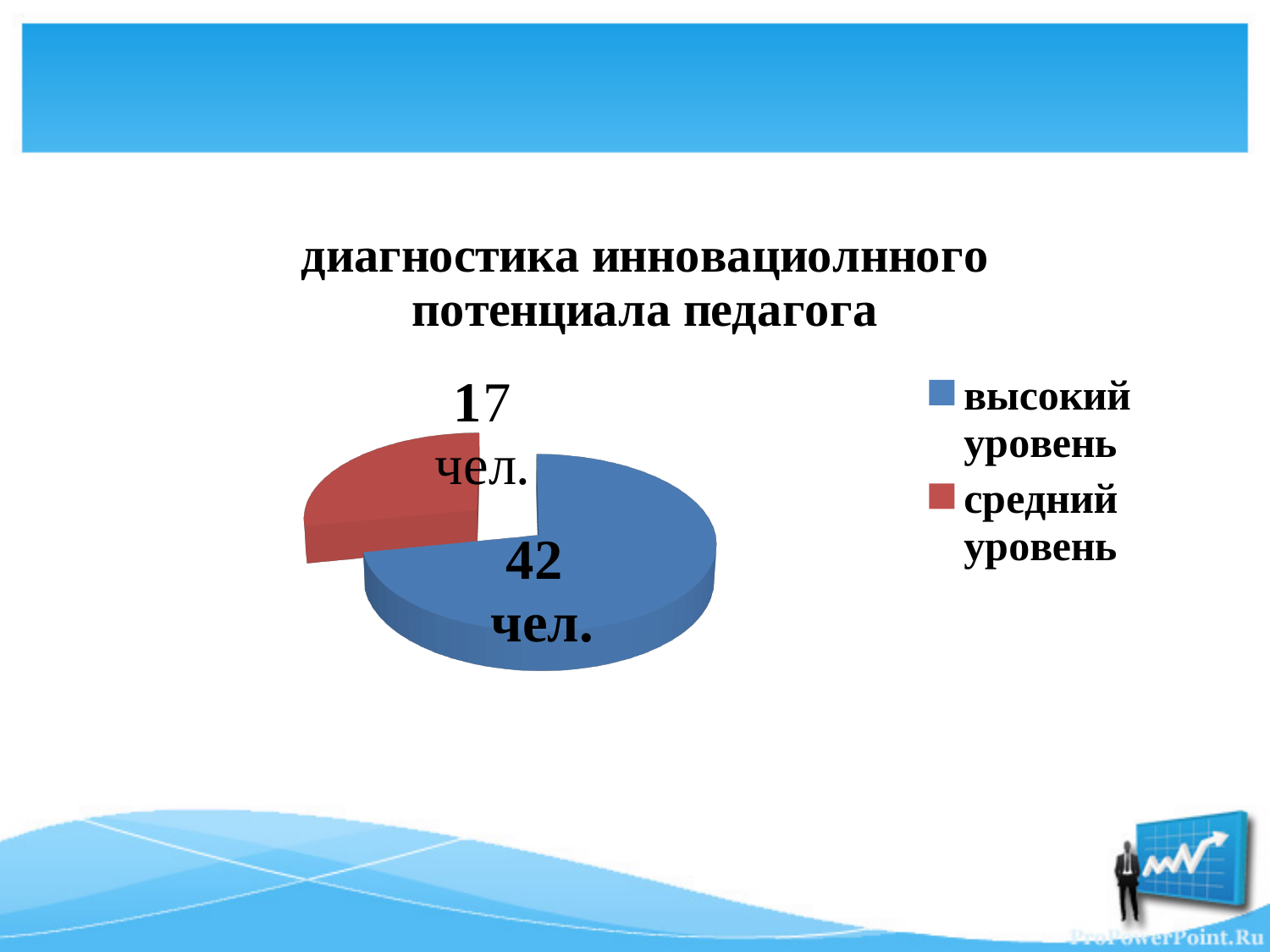
How many entries does the legend list? 2 How many slices does the pie chart have? 2 What is the total of the two slices in the pie chart? 59 чел. What is the value for высокий уровень? 42 чел. What is the difference between the values for высокий уровень and средний уровень? 25 чел. What colour is the slice for средний уровень? red What is the value for средний уровень? 17 чел. Which is larger: the value for высокий уровень or for средний уровень? высокий уровень What kind of chart is shown on the slide? pie chart What is the title of the chart? диагностика инновациолнного потенциала педагога Which category has the smallest slice? средний уровень Which category has the largest slice? высокий уровень